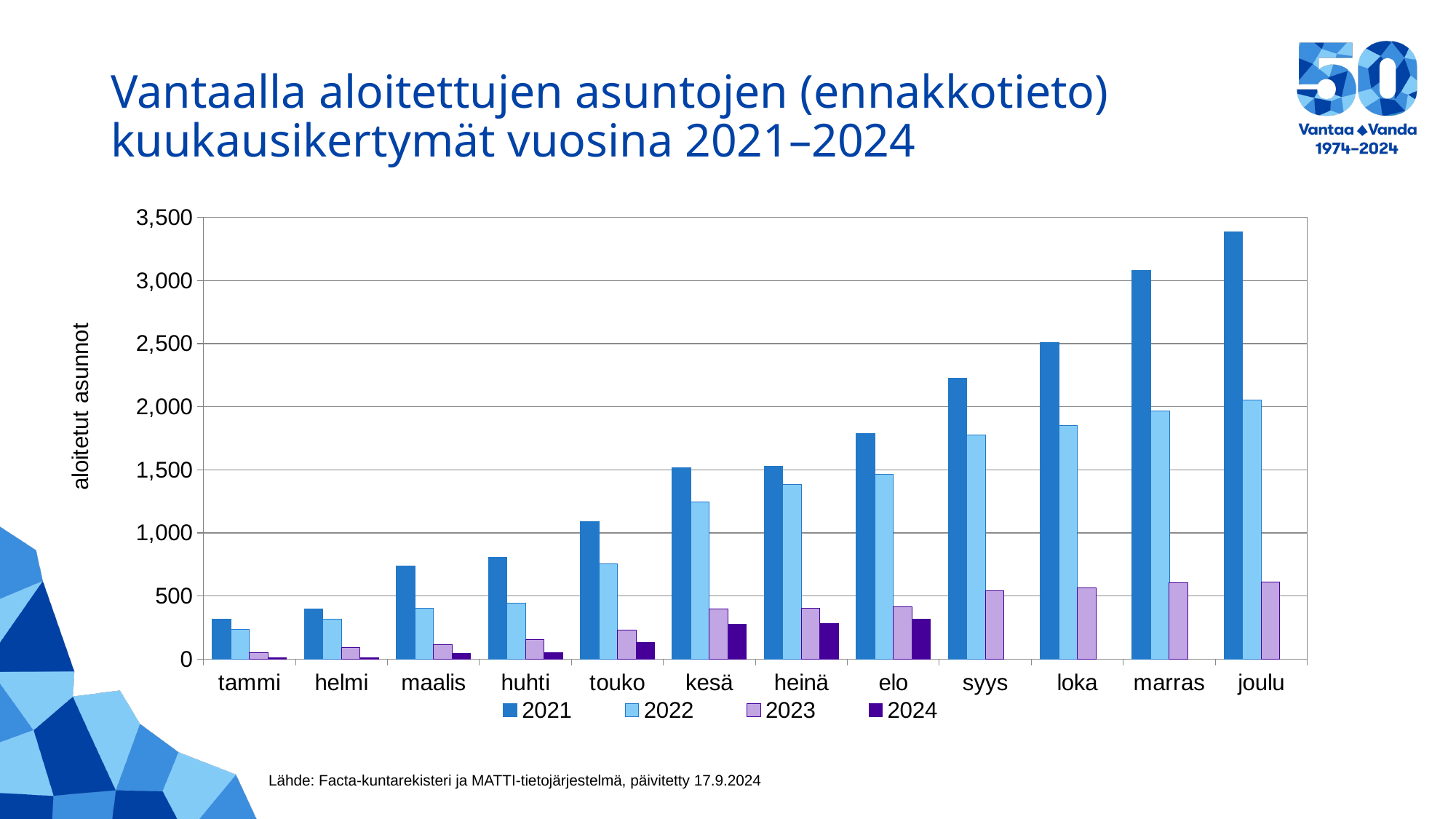
Is the 2023 value for joulu greater or less than 500? greater Which month has the highest value for the 2021 series? joulu Is the 2021 value for joulu greater or less than 3,000? greater How many months are shown on the x axis? 12 Is the 2024 value for elo greater or less than 500? less Do the 2021 values rise or fall from tammi to joulu? rise Which month has the lowest value for the 2021 series? tammi How many series does the legend list? 4 What is the label of the y axis? aloitetut asunnot What kind of chart is shown on the slide? bar chart For kesä, which series has the larger value, 2021 or 2022? 2021